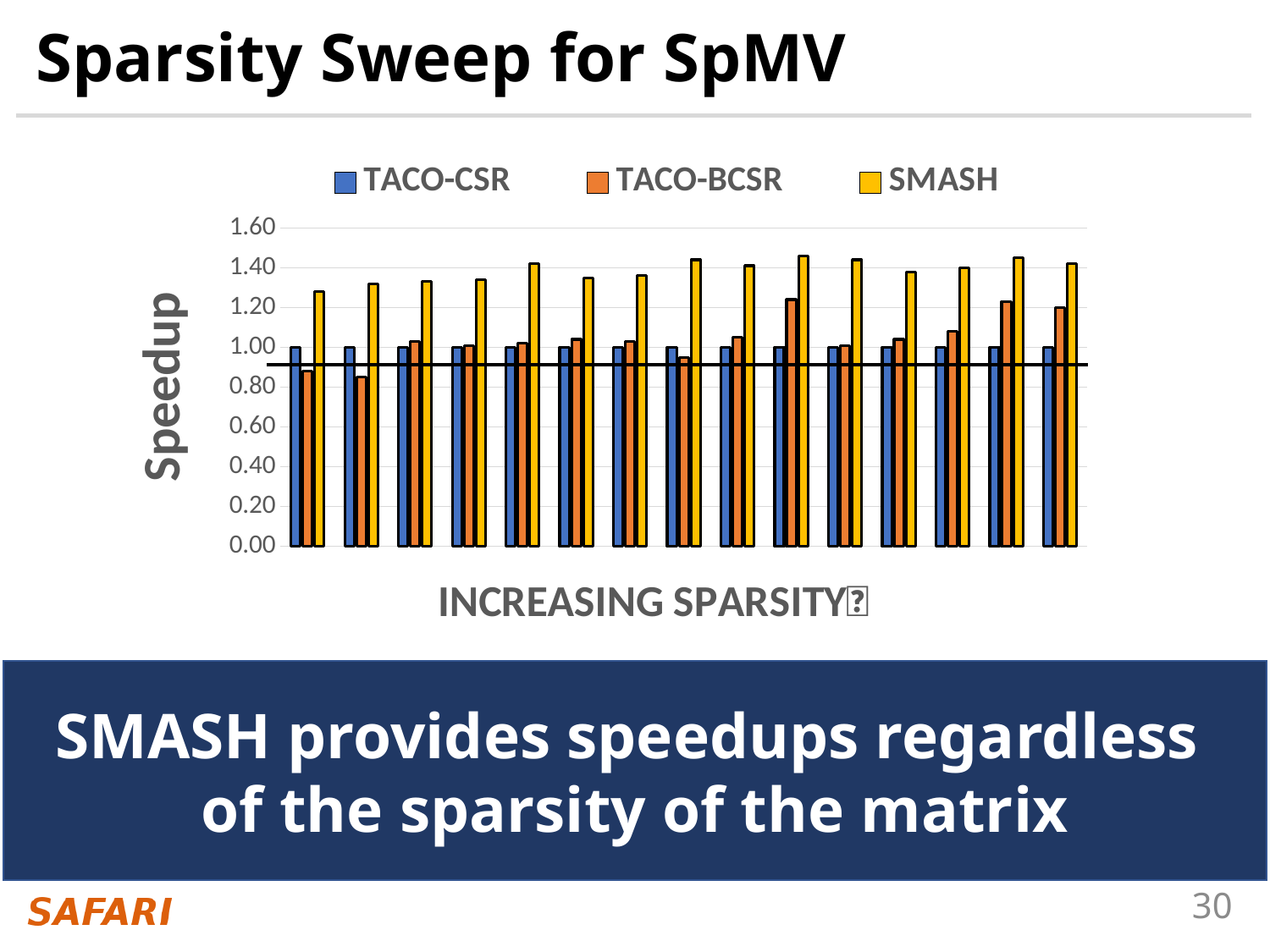
How many series does the legend list? 3 Which series has the tallest bar in every group? SMASH How many groups of bars are plotted along the x axis? 15 In the leftmost group, is the TACO-BCSR bar greater or less than 1.00? less In the leftmost group, is the SMASH bar greater or less than 1.20? greater In the rightmost group, which is larger, the SMASH bar or the TACO-BCSR bar? SMASH What is the title of the slide containing the chart? Sparsity Sweep for SpMV Which series has the tallest bar in the leftmost group? SMASH Which series has the shortest bar in the leftmost group? TACO-BCSR What kind of chart is shown on the slide? bar chart In the rightmost group, is the SMASH bar greater or less than 1.20? greater What is the label on the y axis? Speedup